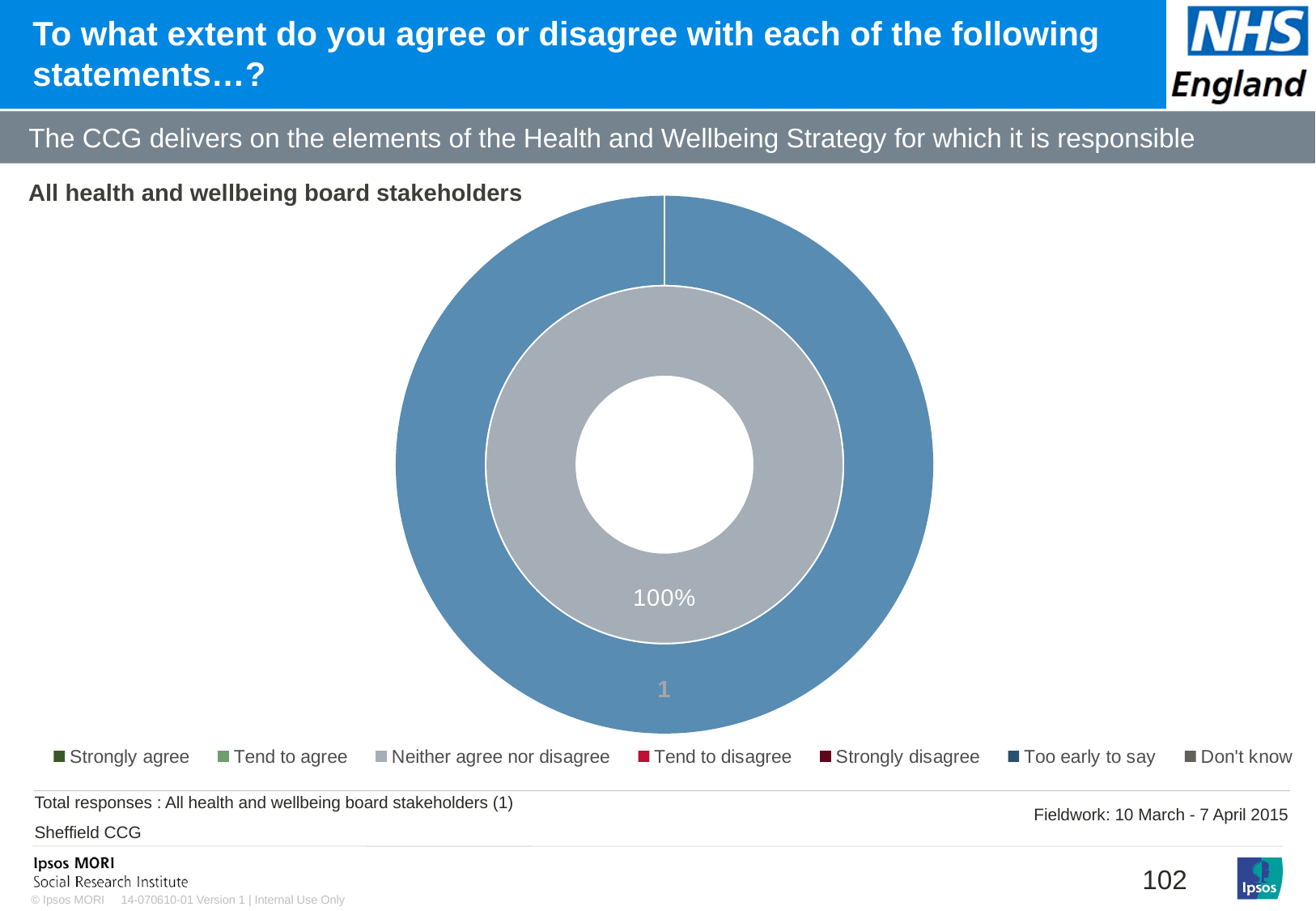
How many entries does the legend list? 7 Which response category is the largest in the inner ring? Neither agree nor disagree Is the value for 'Neither agree nor disagree' greater or less than 50%? greater What is the heading printed above the chart? All health and wellbeing board stakeholders Which legend category does the grey segment labelled 100% correspond to? Neither agree nor disagree What kind of chart is shown on the slide? Doughnut (pie) chart What colour is the legend marker for 'Tend to disagree'? Red What share of the inner ring does 'Neither agree nor disagree' take up? 100% How many percentage data labels are printed on the chart? 1 What percentage is printed on the grey segment of the inner ring? 100%